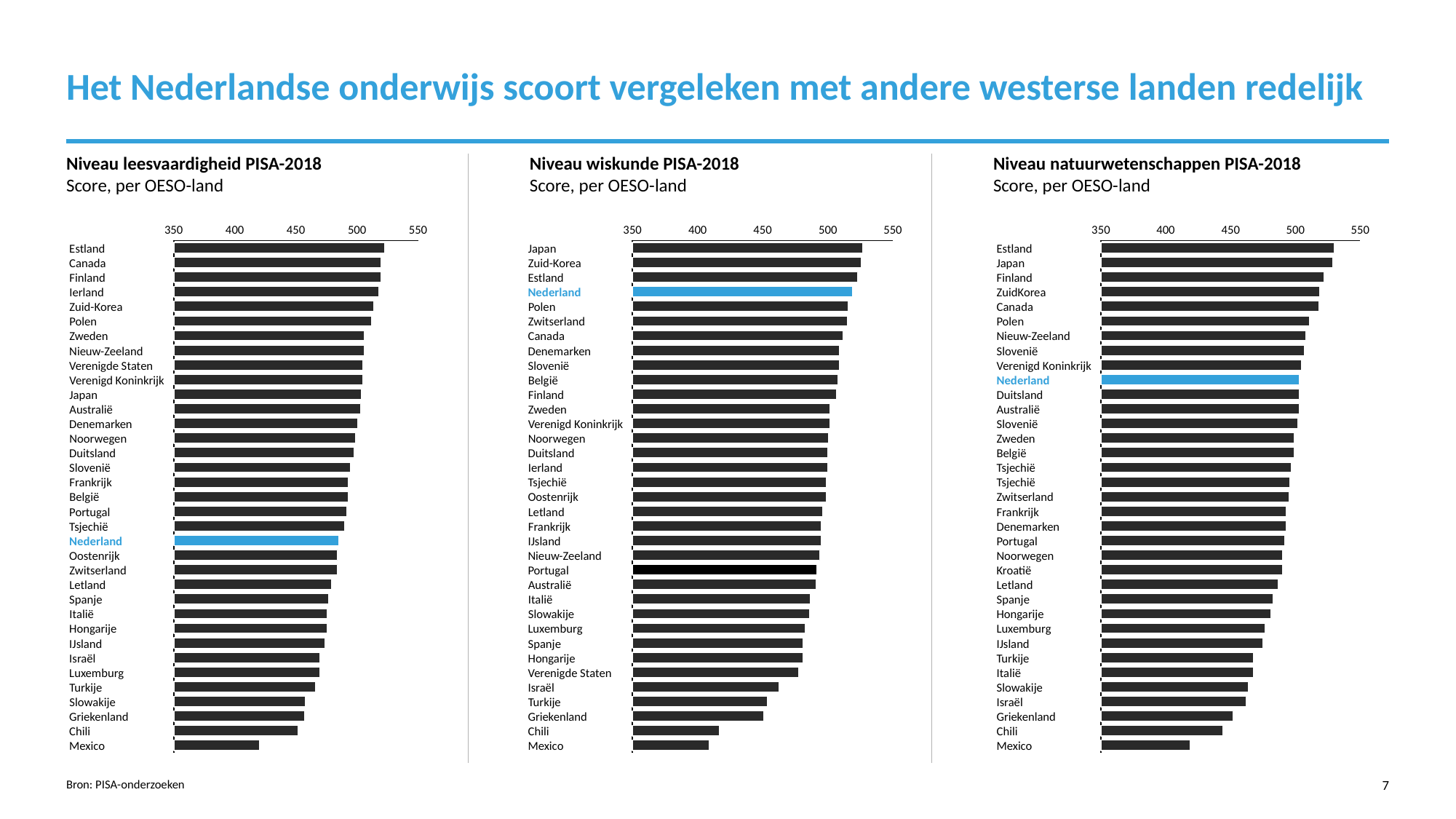
In the 'Niveau natuurwetenschappen PISA-2018' chart, which country's bar is highlighted in blue? Nederland In the 'Niveau wiskunde PISA-2018' chart, which country has the highest score? Japan In the 'Niveau leesvaardigheid PISA-2018' chart, which country has the highest score? Estland How many countries are shown in the 'Niveau wiskunde PISA-2018' chart? 35 In the 'Niveau natuurwetenschappen PISA-2018' chart, which country has the lowest score? Mexico In the 'Niveau natuurwetenschappen PISA-2018' chart, is the value for Estland greater or less than 500? greater In the 'Niveau leesvaardigheid PISA-2018' chart, which country has the lowest score? Mexico In the 'Niveau leesvaardigheid PISA-2018' chart, is the value for Nederland greater or less than 500? less In the 'Niveau wiskunde PISA-2018' chart, which is larger, the value for Nederland or the value for Chili? Nederland In the 'Niveau wiskunde PISA-2018' chart, is the value for Nederland greater or less than 500? greater What kind of chart is the 'Niveau leesvaardigheid PISA-2018' chart? bar chart